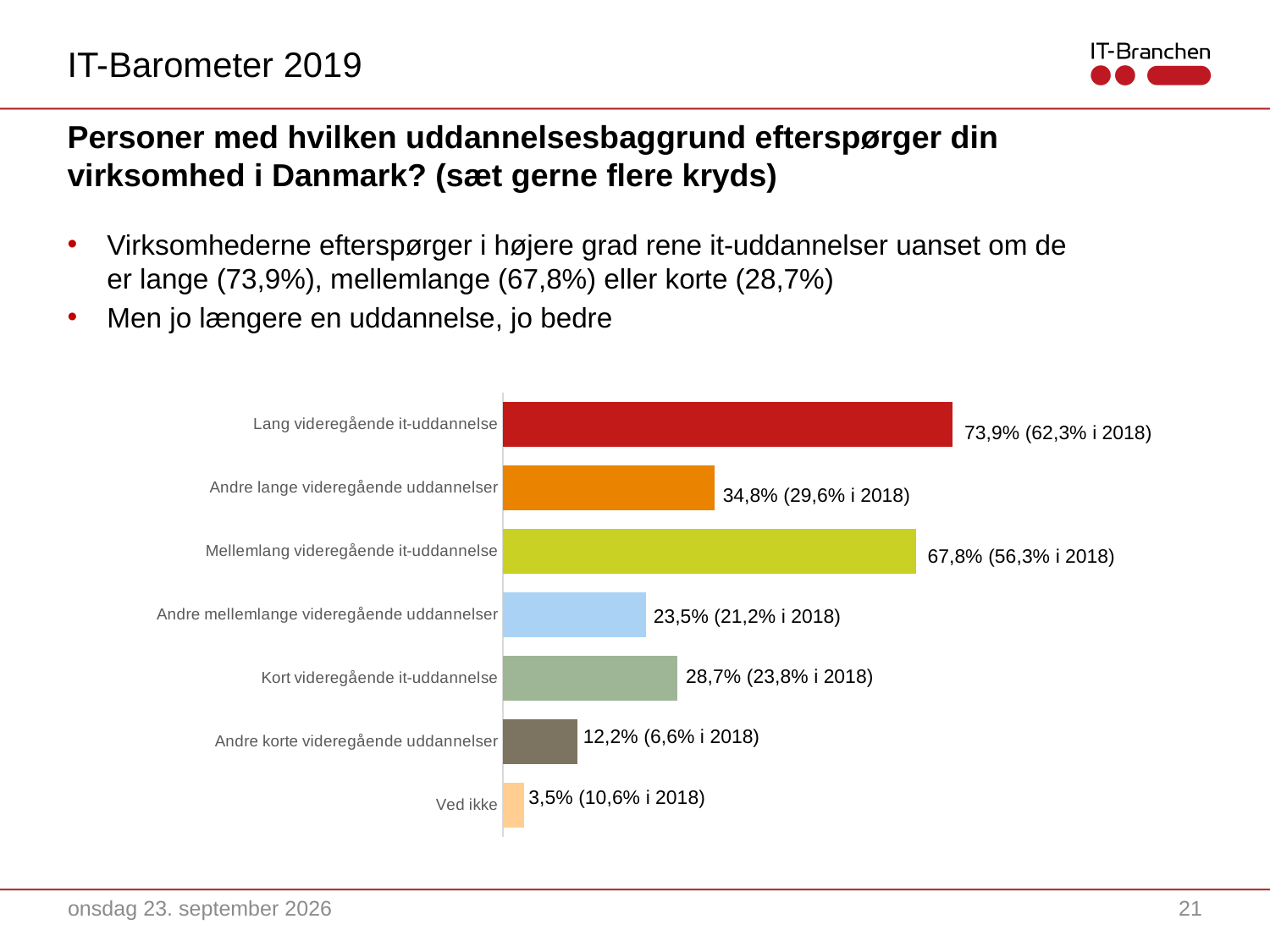
What is the value for "Ved ikke"? 3,5% By how much did the value for "Ved ikke" fall from 2018 (10,6%) to 2019 (3,5%)? 7,1 percentage points What was the 2018 value shown for "Andre korte videregående uddannelser"? 6,6% What is the value for "Lang videregående it-uddannelse"? 73,9% What kind of chart is shown on the slide? Bar chart What colour is the bar for "Lang videregående it-uddannelse"? Red Which is larger: "Andre lange videregående uddannelser" or "Kort videregående it-uddannelse"? Andre lange videregående uddannelser Which category has the highest value? Lang videregående it-uddannelse What is the value for "Kort videregående it-uddannelse"? 28,7% What is the difference between "Lang videregående it-uddannelse" (73,9%) and "Mellemlang videregående it-uddannelse" (67,8%)? 6,1 percentage points How many categories does the bar chart show? 7 Which category has the lowest value? Ved ikke